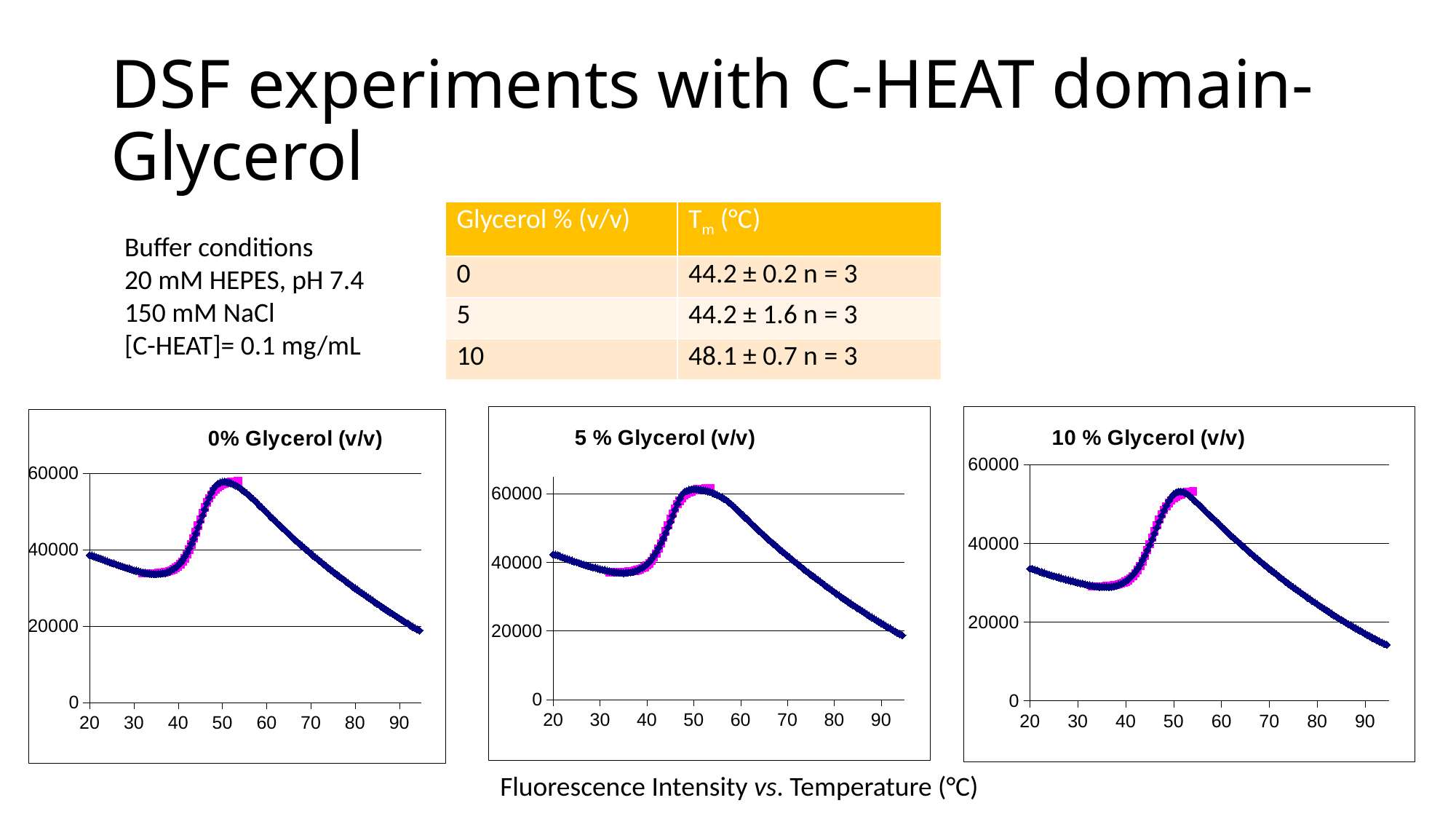
What kind of chart is the '0% Glycerol (v/v)' chart? line chart In the '0% Glycerol (v/v)' chart, is the value at a temperature of 80 greater or less than 40000? less In the '5 % Glycerol (v/v)' chart, does the curve rise or fall between temperatures of 40 and 50? rise What is the highest tick value shown on the y axis of the '5 % Glycerol (v/v)' chart? 60000 In the '5 % Glycerol (v/v)' chart, is the peak fluorescence value greater or less than 40000? greater In the '10 % Glycerol (v/v)' chart, is the value at a temperature of 30 greater or less than 40000? less How many charts are shown on the slide? 3 What is the title of the middle chart? 5 % Glycerol (v/v) In the '0% Glycerol (v/v)' chart, does the curve rise or fall between temperatures of 60 and 90? fall In the '10 % Glycerol (v/v)' chart, does the curve rise or fall between temperatures of 70 and 90? fall